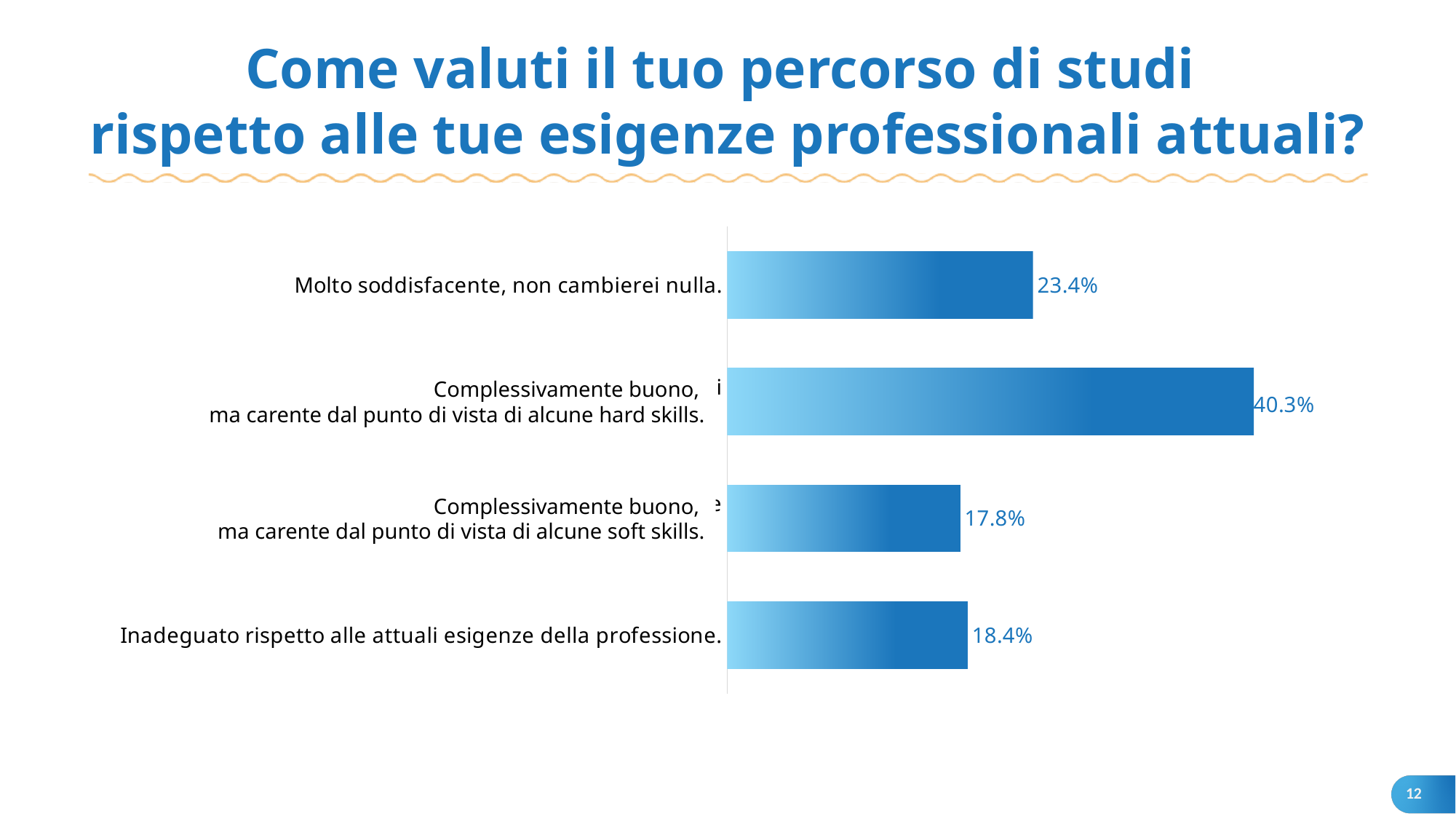
What is the difference between the value for "Complessivamente buono, ma carente dal punto di vista di alcune hard skills." and the value for "Molto soddisfacente, non cambierei nulla."? 16.9% What is the value for "Complessivamente buono, ma carente dal punto di vista di alcune soft skills."? 17.8% What kind of chart is shown on the slide? Bar chart Which category has the lowest value? Complessivamente buono, ma carente dal punto di vista di alcune soft skills. How many categories are shown in the chart? 4 What is the value for "Molto soddisfacente, non cambierei nulla."? 23.4% What is the value for "Inadeguato rispetto alle attuali esigenze della professione."? 18.4% What is the title of the slide containing the chart? Come valuti il tuo percorso di studi rispetto alle tue esigenze professionali attuali? Which category has the highest value? Complessivamente buono, ma carente dal punto di vista di alcune hard skills. Which is larger: the value for "Molto soddisfacente, non cambierei nulla." or the value for "Inadeguato rispetto alle attuali esigenze della professione."? Molto soddisfacente, non cambierei nulla. What is the difference between the value for "Inadeguato rispetto alle attuali esigenze della professione." and the value for "Complessivamente buono, ma carente dal punto di vista di alcune soft skills."? 0.6% What is the value for "Complessivamente buono, ma carente dal punto di vista di alcune hard skills."? 40.3%